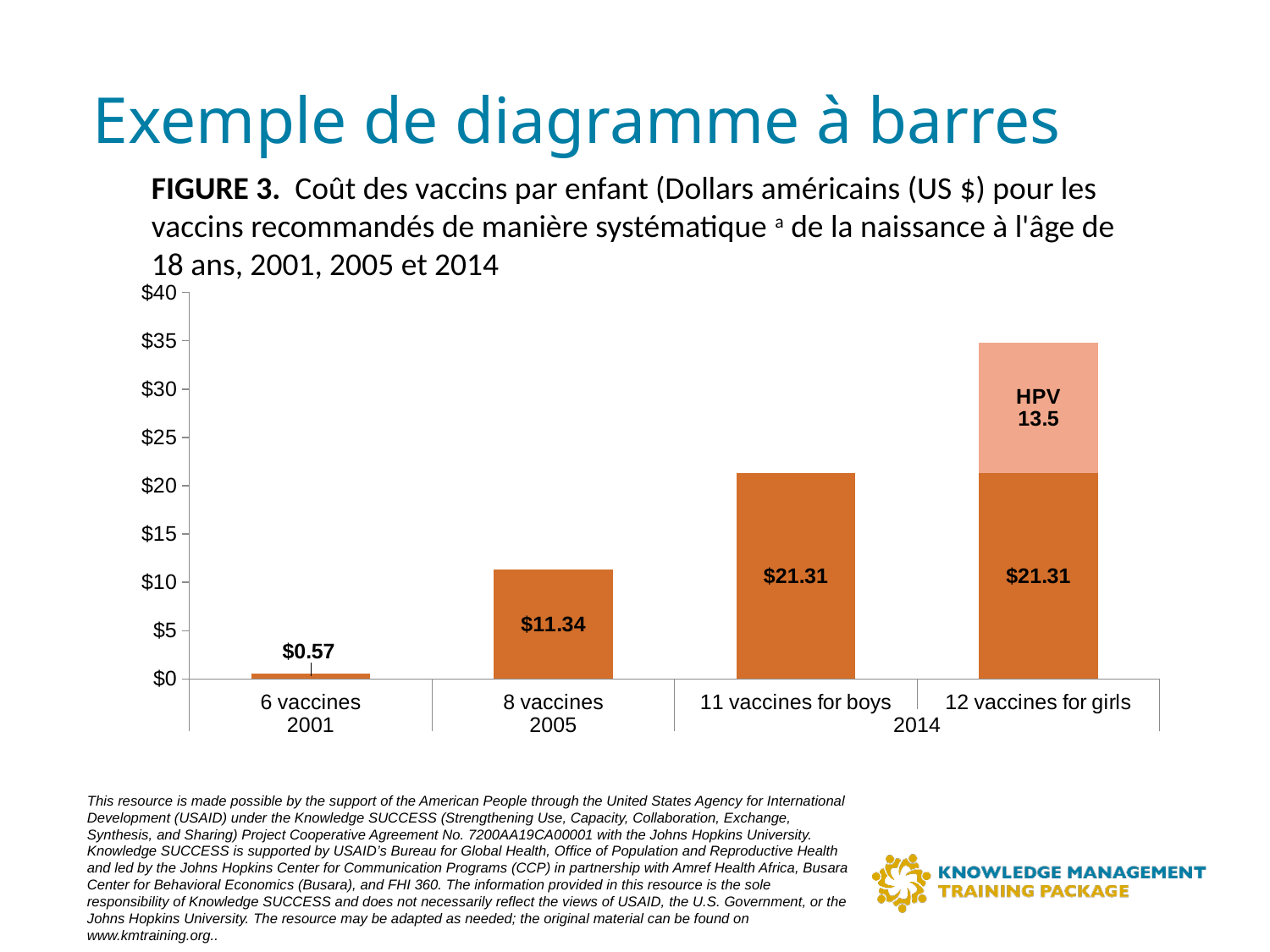
What is the cost per child for 8 vaccines in 2005? $11.34 What is the cost per child for 6 vaccines in 2001? $0.57 Is the cost for 11 vaccines for boys greater or less than $20? greater What is the total cost of the stacked bar for 12 vaccines for girls? $34.81 What is the value of the HPV segment in the 12 vaccines for girls bar? 13.5 What is the difference in cost between 8 vaccines in 2005 and 6 vaccines in 2001? $10.77 Do the costs rise or fall from 2001 to 2014 along the x axis? Rise How many bars are shown in the chart? 4 Which category has the highest total cost per child? 12 vaccines for girls (2014) What is the cost per child for 11 vaccines for boys in 2014? $21.31 What kind of chart is shown on the slide? Bar chart Which category has the lowest cost per child? 6 vaccines (2001)